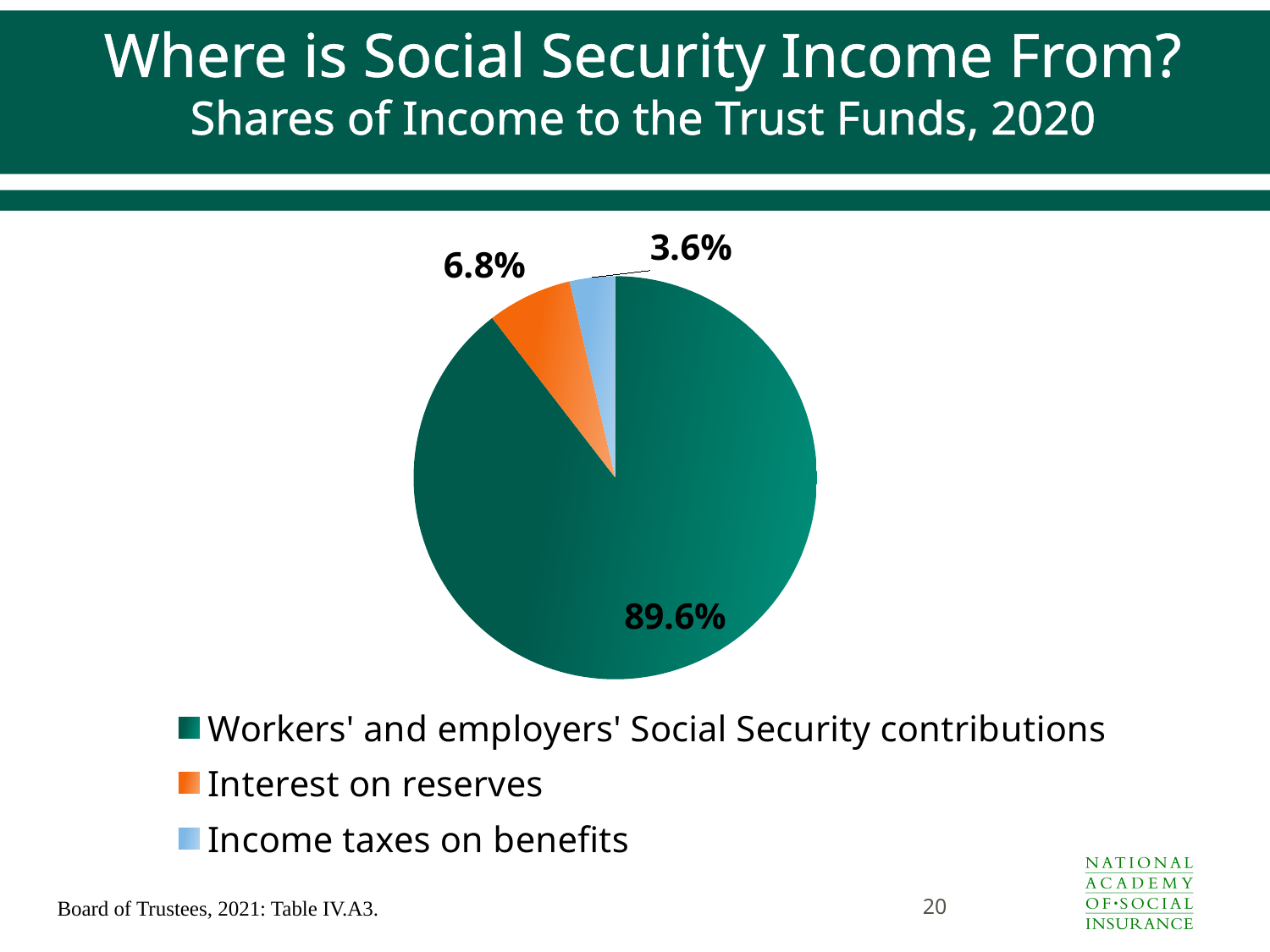
How many percentage points larger is the share from interest on reserves than the share from income taxes on benefits? 3.2 percentage points How many slices does the pie chart have? 3 What kind of chart is shown on the slide? Pie chart Which source provides the largest share of income to the trust funds? Workers' and employers' Social Security contributions Which source provides the smallest share of income to the trust funds? Income taxes on benefits What share of income to the trust funds comes from interest on reserves? 6.8% What share of income to the trust funds comes from workers' and employers' Social Security contributions? 89.6% What share of income to the trust funds comes from income taxes on benefits? 3.6% What year does the chart's data refer to? 2020 Which is larger: the share from interest on reserves or the share from income taxes on benefits? Interest on reserves What colour is the slice for interest on reserves? Orange How many entries does the legend list? 3